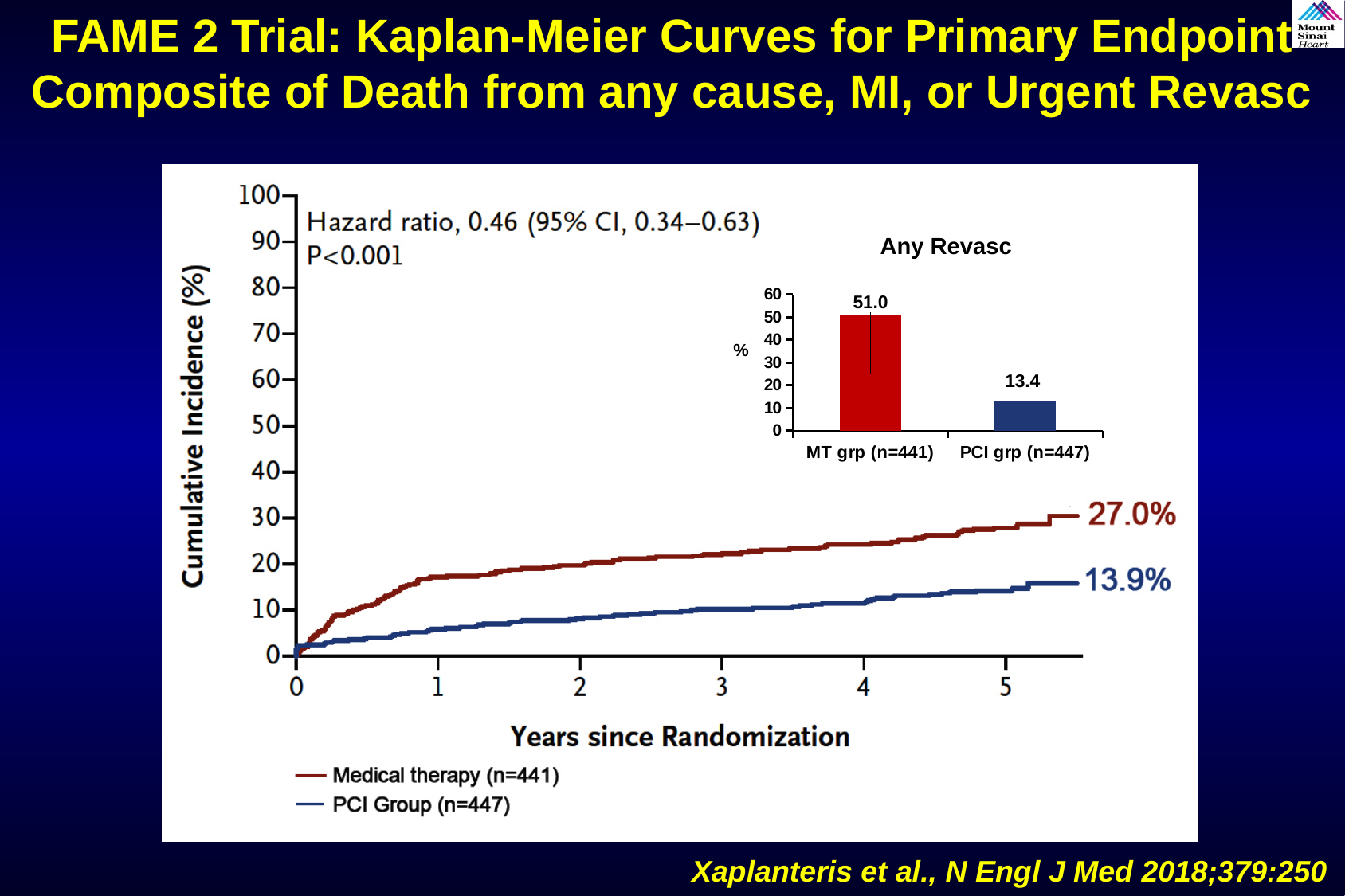
In the Kaplan-Meier chart, what is the final cumulative incidence labelled for the PCI Group? 13.9% In the Kaplan-Meier chart, how many groups does the legend list? 2 In the 'Any Revasc' inset chart, how many groups are plotted? 2 In the 'Any Revasc' inset chart, what is the value for MT grp (n=441)? 51.0 In the Kaplan-Meier chart, what is the final cumulative incidence labelled for the Medical therapy group? 27.0% In the 'Any Revasc' inset chart, what is the value for PCI grp (n=447)? 13.4 In the Kaplan-Meier chart, what hazard ratio is printed on the plot? 0.46 In the 'Any Revasc' inset chart, what is the difference between the MT grp and PCI grp values? 37.6 What kind of chart is the 'Any Revasc' inset? bar chart In the Kaplan-Meier chart, what is the difference between the final labelled values for the Medical therapy group and the PCI Group? 13.1% In the Kaplan-Meier chart, do the curves rise or fall as years since randomization increase? rise In the Kaplan-Meier chart, which group has the higher cumulative incidence at the end of follow-up? Medical therapy